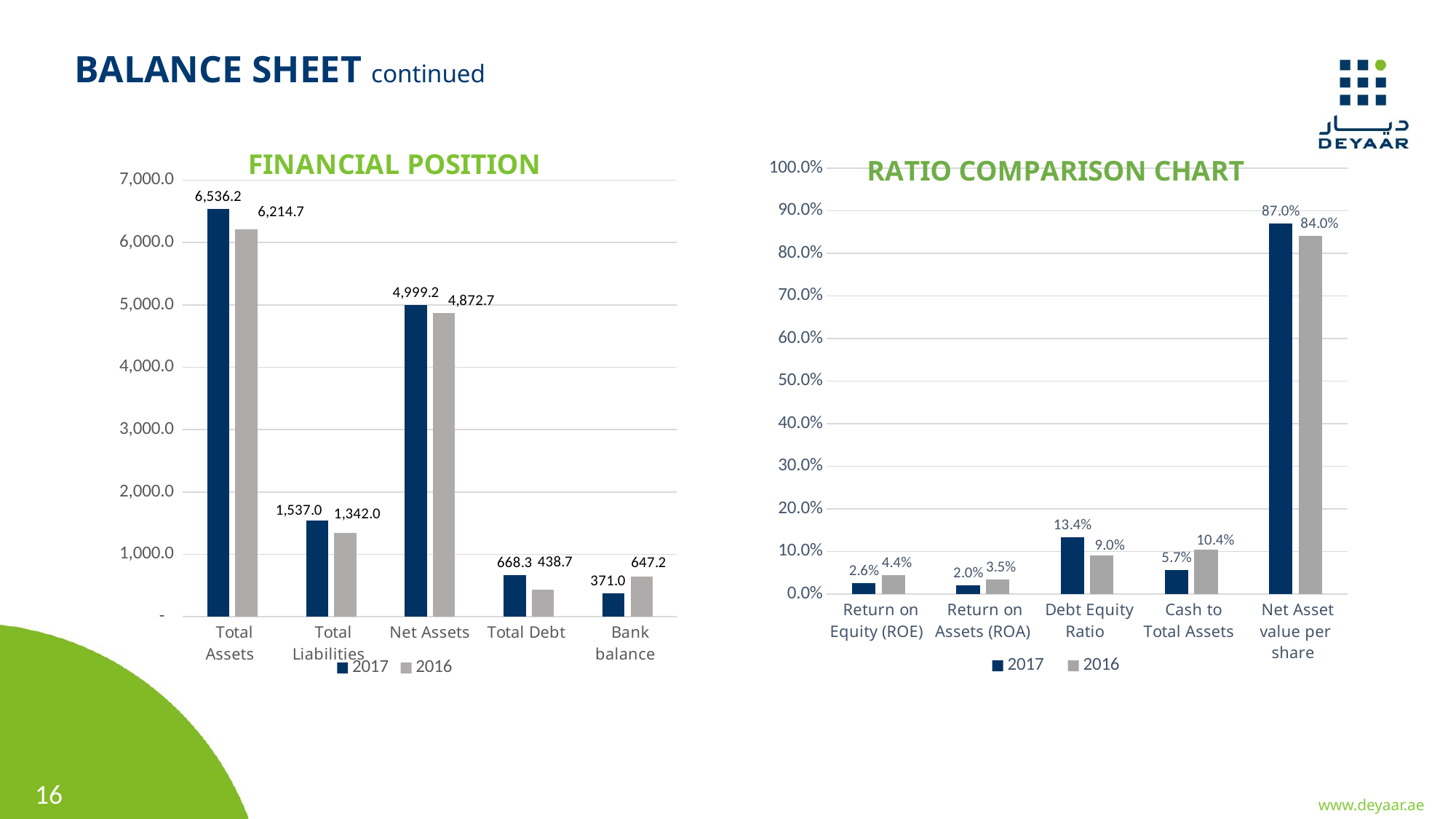
In the RATIO COMPARISON CHART, which category has the highest 2016 value? Net Asset value per share In the FINANCIAL POSITION chart, is Net Assets larger in 2017 or 2016? 2017 In the FINANCIAL POSITION chart, what is the value of Bank balance for 2016? 647.2 In the FINANCIAL POSITION chart, which category has the lowest 2017 value? Bank balance What type of chart is the RATIO COMPARISON CHART? Bar chart In the FINANCIAL POSITION chart, how many categories are shown on the x axis? 5 In the RATIO COMPARISON CHART, how many series does the legend list? 2 In the FINANCIAL POSITION chart, what is the value of Total Assets for 2017? 6,536.2 In the RATIO COMPARISON CHART, what is Cash to Total Assets for 2016? 10.4% In the RATIO COMPARISON CHART, what is the difference between Net Asset value per share in 2017 and 2016? 3.0% In the RATIO COMPARISON CHART, what is the Debt Equity Ratio for 2017? 13.4% In the FINANCIAL POSITION chart, what is the difference between Total Debt in 2017 and 2016? 229.6